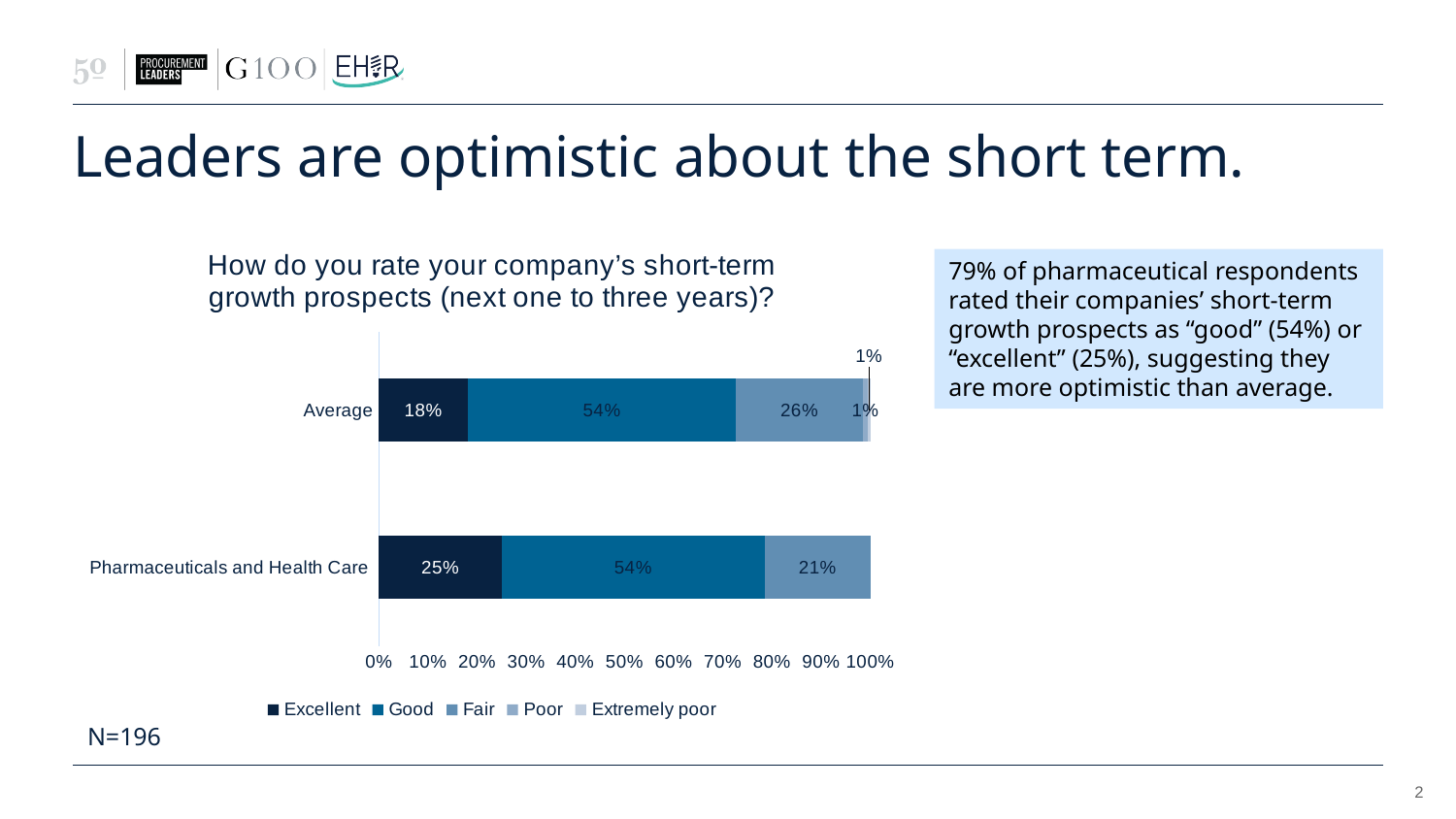
How many categories are plotted on the chart? 2 What is the difference between the Excellent values for Pharmaceuticals and Health Care and Average? 7% What is the Fair value for the Average category? 26% What is the Good value for Pharmaceuticals and Health Care? 54% How many series does the legend list? 5 What percentage of Average respondents rated their short-term growth prospects as Excellent? 18% What kind of chart is shown on the slide? Stacked bar chart What is the combined Excellent and Good share for Pharmaceuticals and Health Care? 79% What is the Poor value for the Average category? 1% What percentage of Pharmaceuticals and Health Care respondents rated their short-term growth prospects as Excellent? 25% What is the Fair value for Pharmaceuticals and Health Care? 21% Which category has the higher Excellent value, Average or Pharmaceuticals and Health Care? Pharmaceuticals and Health Care